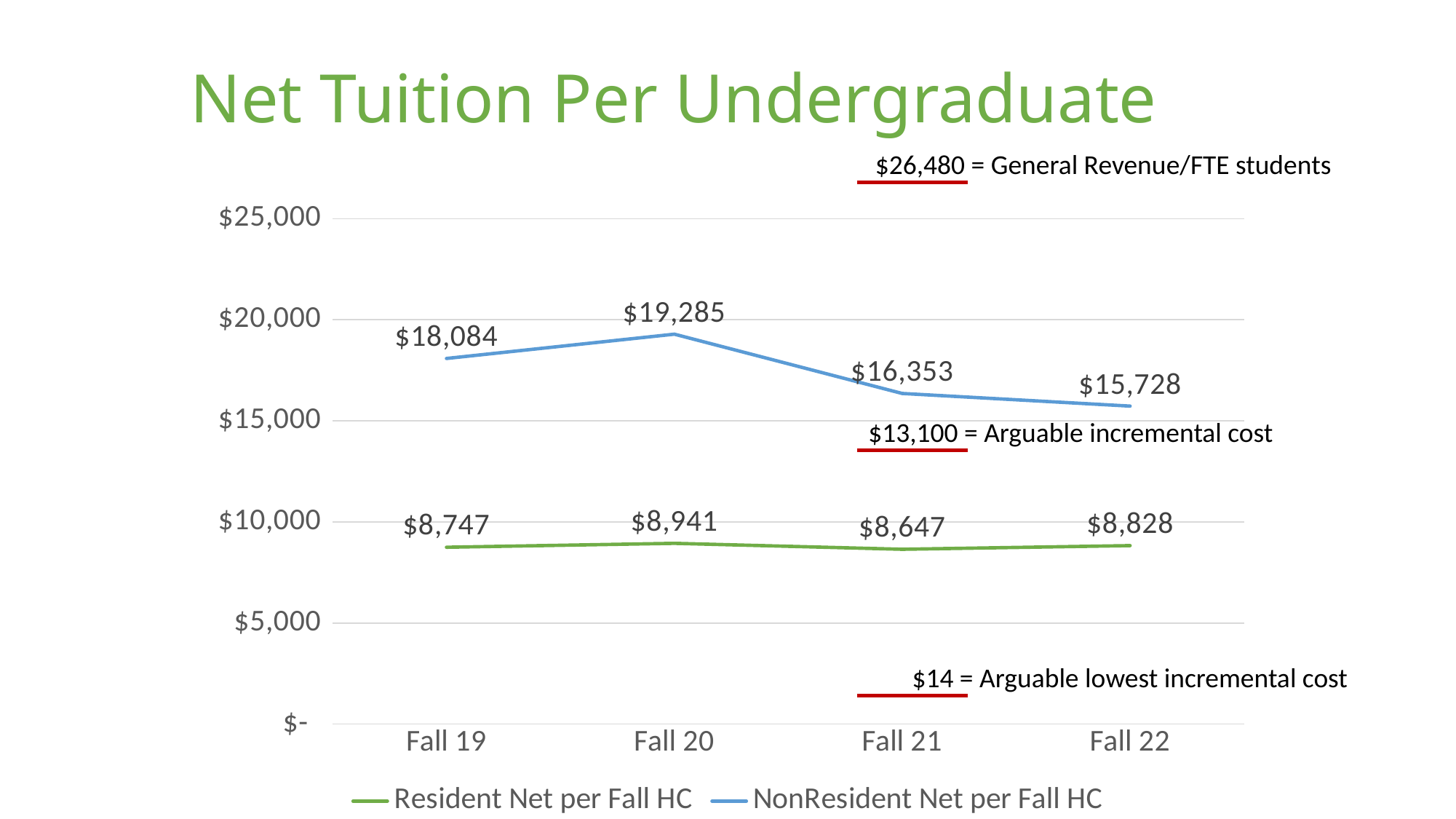
Is the NonResident Net per Fall HC value for Fall 21 greater or less than $15,000? greater What is the NonResident Net per Fall HC value for Fall 20? $19,285 How many terms are shown on the x axis? 4 Does the NonResident Net per Fall HC rise or fall from Fall 20 to Fall 22? fall What is the Resident Net per Fall HC value for Fall 21? $8,647 What is the difference between the NonResident and Resident Net per Fall HC values in Fall 19? $9,337 What kind of chart is shown on the slide? line chart What is the NonResident Net per Fall HC value for Fall 22? $15,728 Which is larger: the Resident Net per Fall HC in Fall 20 or in Fall 22? Fall 20 In which term is the NonResident Net per Fall HC highest? Fall 20 In which term is the Resident Net per Fall HC lowest? Fall 21 How many series does the legend list? 2